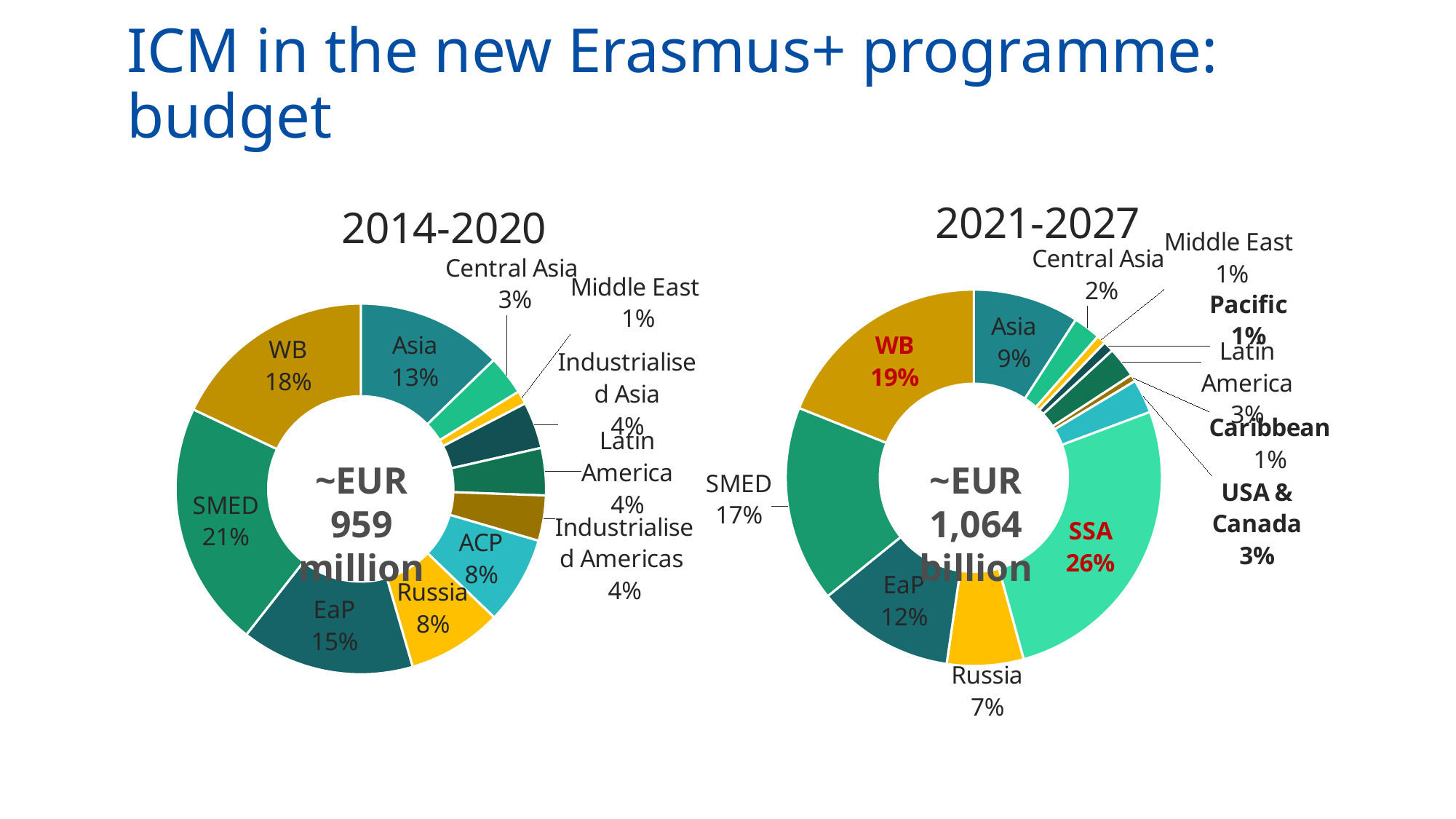
In the 2014-2020 chart, what share of the budget goes to SMED? 21% In the 2021-2027 chart, what is the difference between the shares of WB and SMED? 2% In the 2014-2020 chart, which region has the largest share? SMED In the 2021-2027 chart, what share of the budget goes to SSA? 26% In the 2021-2027 chart, which has the larger share, EaP or Russia? EaP In the 2014-2020 chart, what is the difference between the shares of WB and EaP? 3% In the 2021-2027 chart, which region has the largest share? SSA How many regions are shown in the 2021-2027 chart? 12 What kind of chart is used for the 2014-2020 budget? Pie (donut) chart What total budget is shown in the centre of the 2014-2020 chart? ~EUR 959 million In the 2014-2020 chart, what share of the budget goes to Asia? 13% In the 2014-2020 chart, which region has the smallest share? Middle East